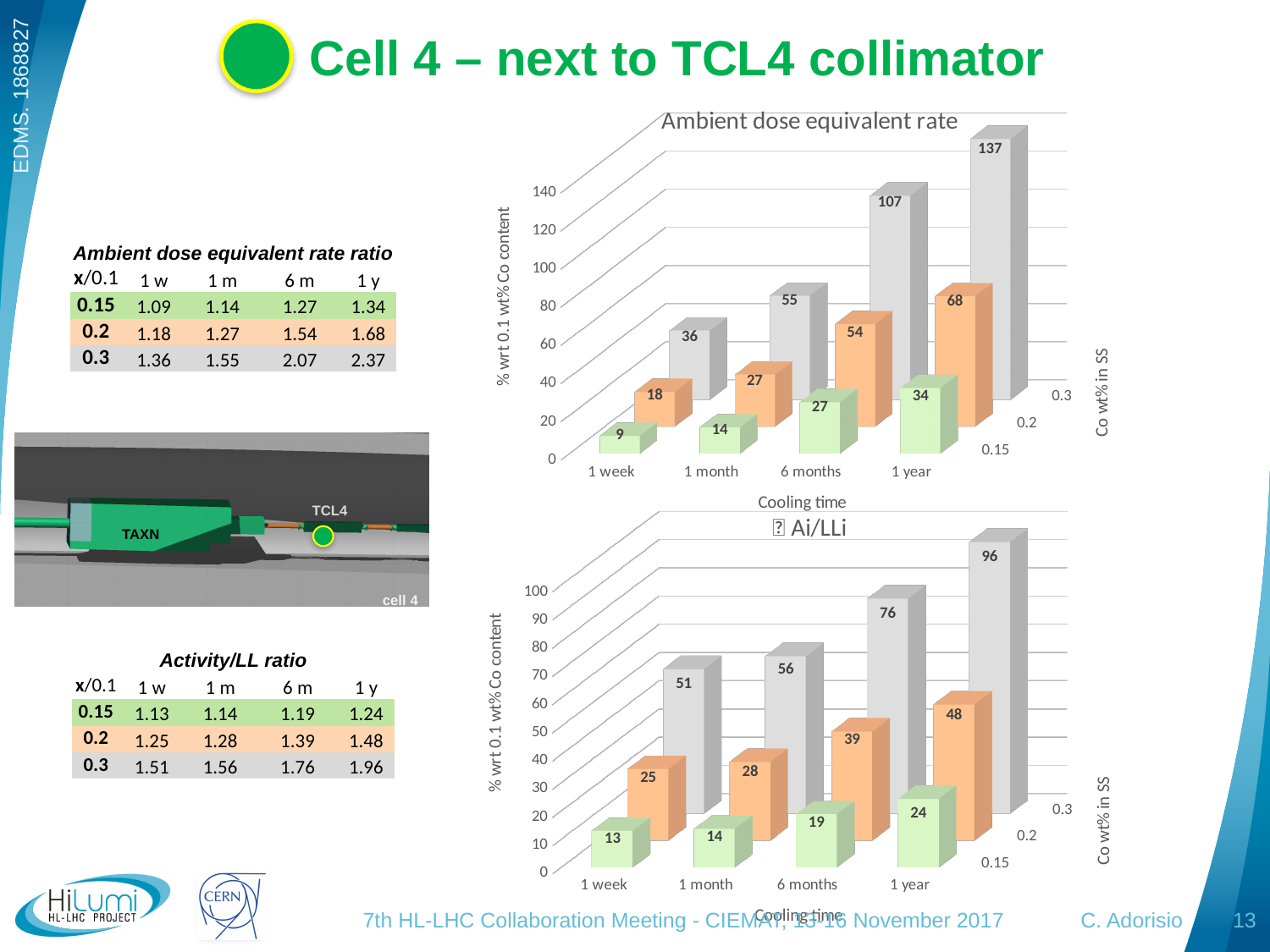
In the top chart titled 'Ambient dose equivalent rate', does the value for the 0.3 Co wt% series at 6 months rise or fall compared with 1 month? rise What kind of chart is the top chart titled 'Ambient dose equivalent rate'? bar chart In the top chart titled 'Ambient dose equivalent rate', what is the value for the 0.15 Co wt% series at 1 week? 9 In the lower chart on the right, what is the value for the 0.3 Co wt% series at 1 year? 96 In the lower chart on the right, what is the value for the 0.15 Co wt% series at 6 months? 19 How many cooling-time categories are shown on the x axis of the top chart titled 'Ambient dose equivalent rate'? 4 In the top chart titled 'Ambient dose equivalent rate', which cooling time has the highest value for the 0.3 Co wt% series? 1 year In the lower chart on the right, which cooling time has the lowest value for the 0.15 Co wt% series? 1 week In the top chart titled 'Ambient dose equivalent rate', what is the value for the 0.3 Co wt% series at 1 year? 137 In the lower chart on the right, which is larger: the 0.2 Co wt% value at 1 year or the 0.3 Co wt% value at 1 week? 0.3 Co wt% value at 1 week In the top chart titled 'Ambient dose equivalent rate', what is the difference between the 0.3 and 0.2 Co wt% values at 1 year? 69 In the top chart titled 'Ambient dose equivalent rate', what is the value for the 0.2 Co wt% series at 6 months? 54